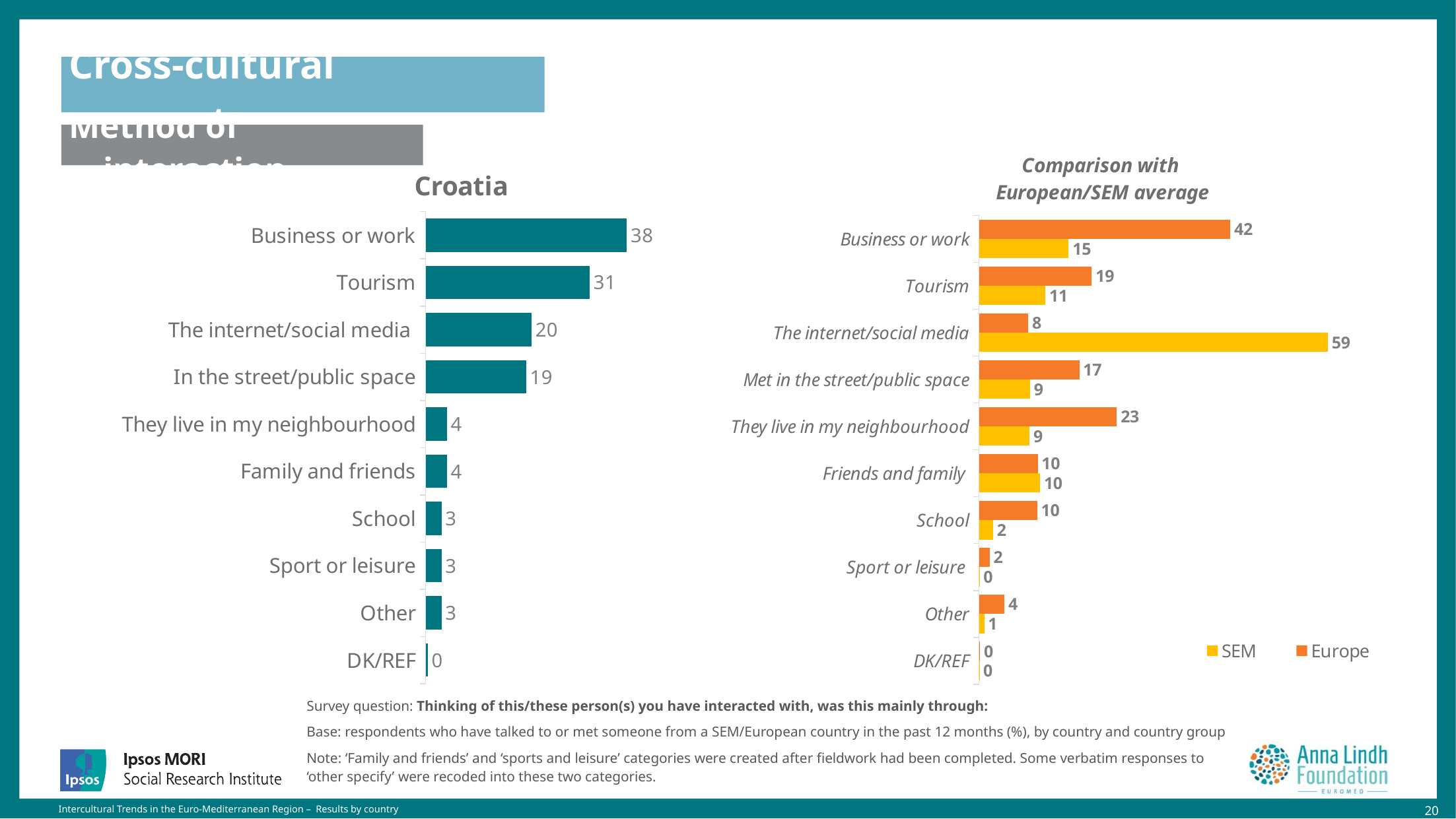
In the Comparison with European/SEM average chart, what is the Europe value for They live in my neighbourhood? 23 How many series does the legend of the Comparison with European/SEM average chart list? 2 In the Comparison with European/SEM average chart, which category has the highest SEM value? The internet/social media In the Croatia chart, how many categories are shown? 10 In the Comparison with European/SEM average chart, which is larger for Business or work: Europe or SEM? Europe In the Croatia chart, which category has the highest value? Business or work In the Comparison with European/SEM average chart, what is the SEM value for The internet/social media? 59 In the Croatia chart, what is the difference between Business or work and The internet/social media? 18 In the Croatia chart, what is the value for Tourism? 31 What type of chart is the Croatia chart? Bar chart In the Comparison with European/SEM average chart, what is the difference between the Europe and SEM values for Tourism? 8 In the Comparison with European/SEM average chart, which colour represents SEM? Yellow